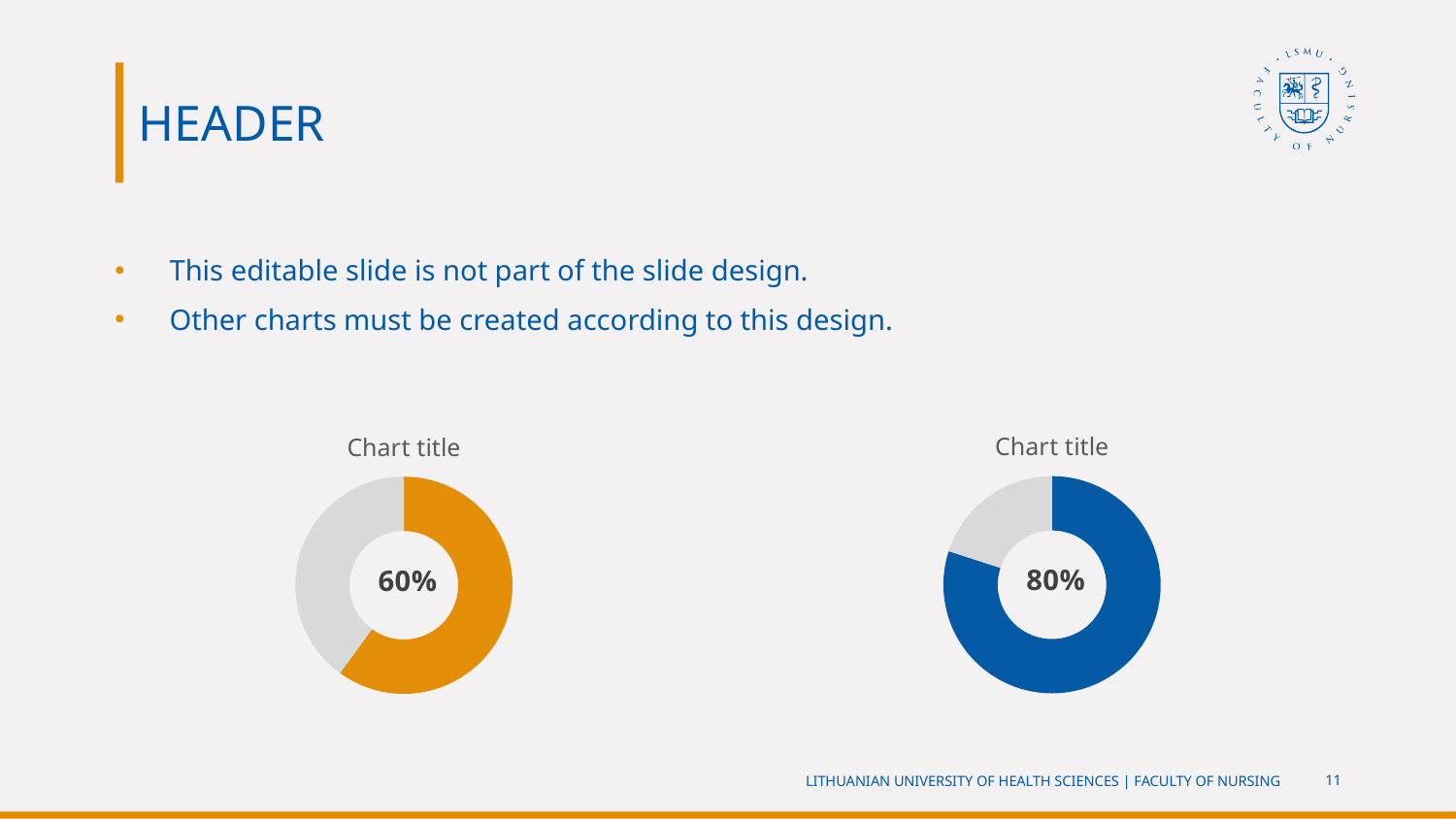
What kind of chart is the right chart? doughnut chart What is the title of the right chart? Chart title What kind of chart is the left chart? doughnut chart Which chart shows the larger percentage, the left one or the right one? the right one How many charts are on the slide? 2 Which chart shows the smaller percentage, the left one or the right one? the left one What is the difference between the percentage on the right chart and the percentage on the left chart? 20 percentage points What percentage is shown in the centre of the left doughnut chart? 60% What percentage is shown in the centre of the right doughnut chart? 80% What colour is the filled portion of the left doughnut chart? orange